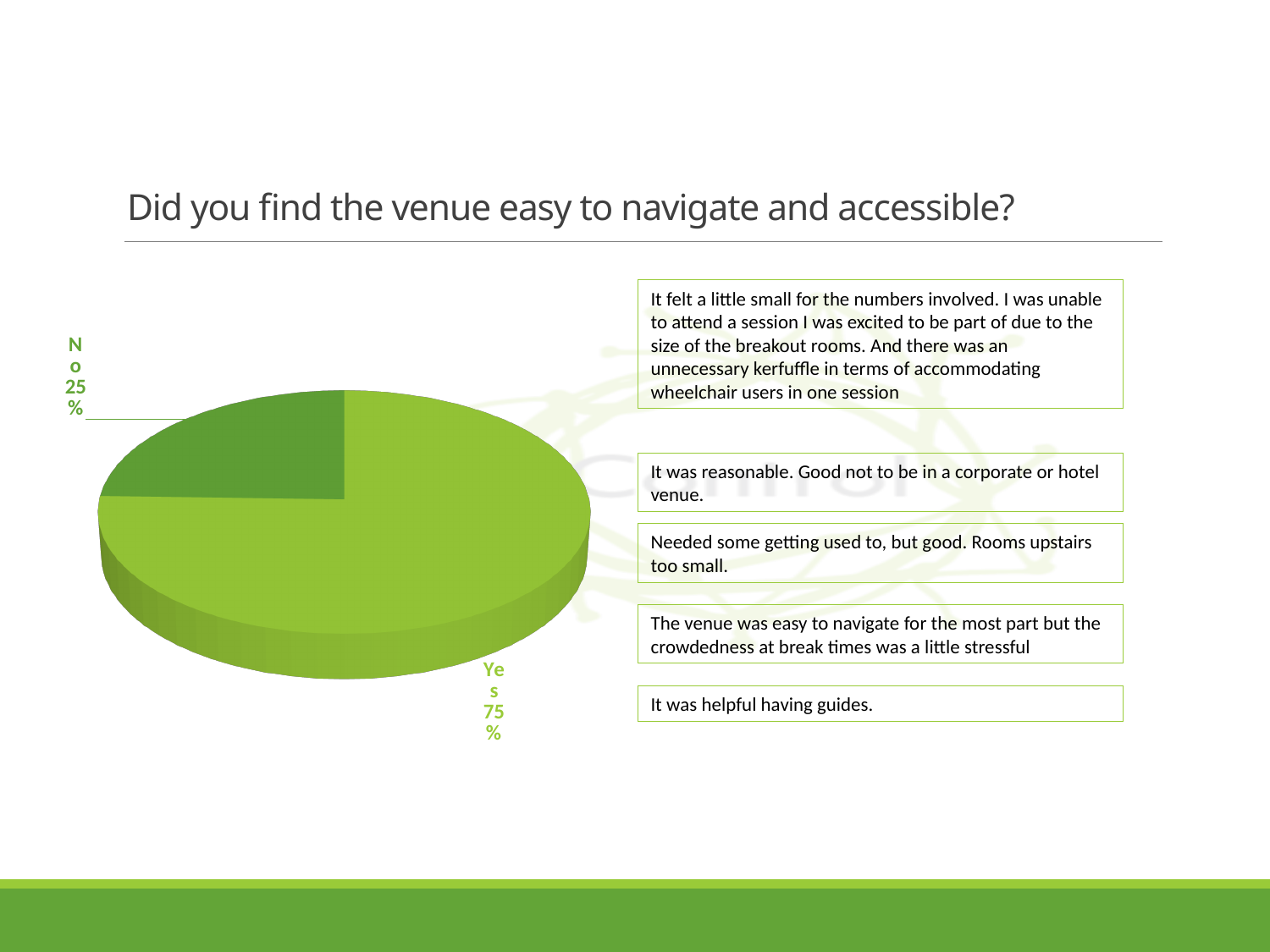
What question does the slide title ask about the venue? Did you find the venue easy to navigate and accessible? Which is larger, the "Yes" slice or the "No" slice? Yes What share of the pie does the "No" slice represent? 25% How many slices does the pie chart have? 2 Which slice of the pie is the smallest? No What kind of chart is shown on the slide? Pie chart Which slice of the pie is the largest? Yes What share of the pie does the "Yes" slice represent? 75% What colour is the "Yes" slice of the pie? Light green What is the difference in percentage points between the "Yes" and "No" slices? 50